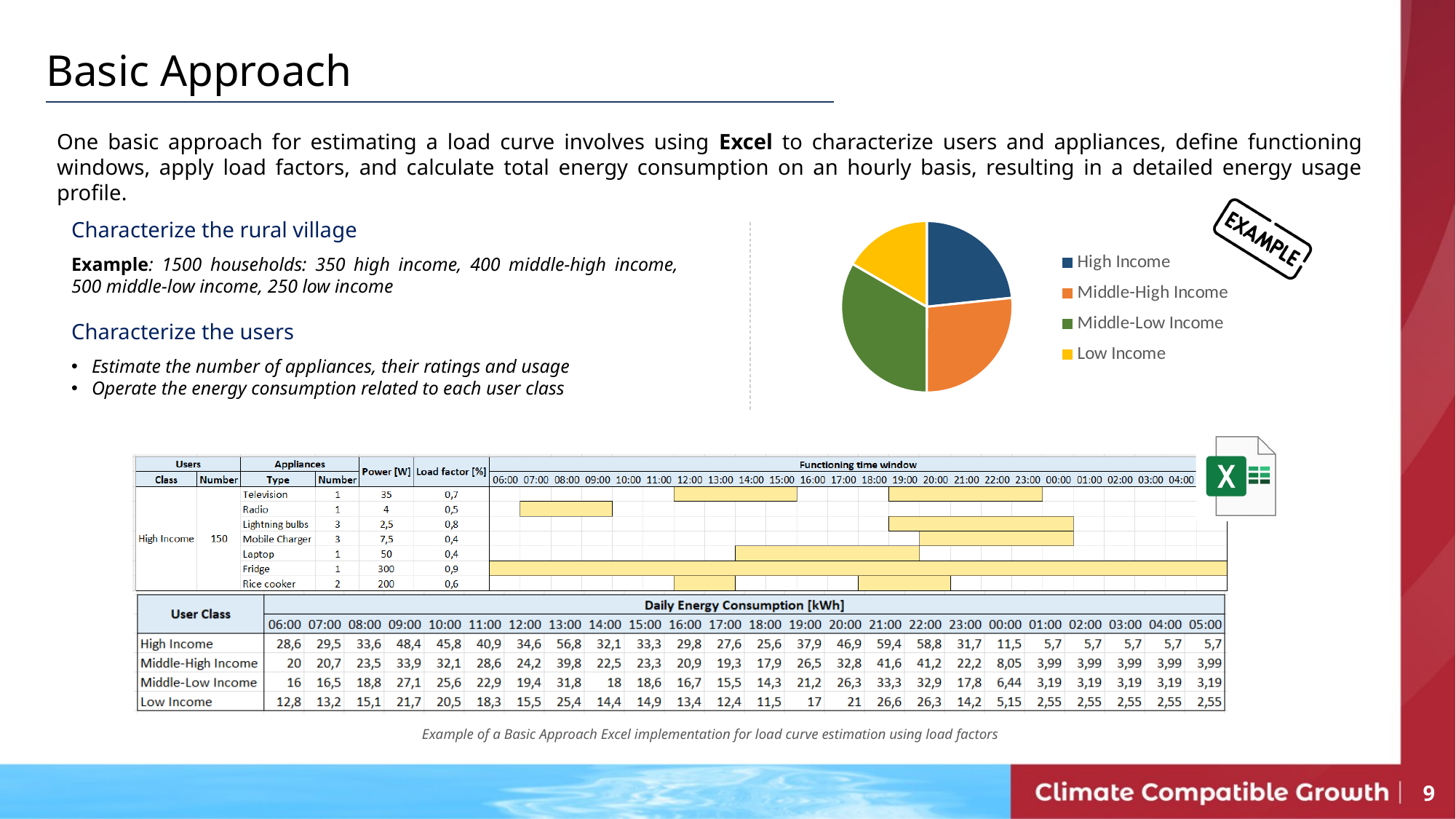
Which user class is shown in green in the pie chart? Middle-Low Income How many slices does the pie chart have? 4 In the pie chart, which slice is larger: Middle-Low Income or High Income? Middle-Low Income What colour represents Low Income in the pie chart? Yellow In the pie chart, which slice is larger: Middle-Low Income or Low Income? Middle-Low Income Which user class has the smallest slice in the pie chart? Low Income What kind of chart is shown in the upper right of the slide? Pie chart How many entries does the pie chart's legend list? 4 Which user class has the largest slice in the pie chart? Middle-Low Income